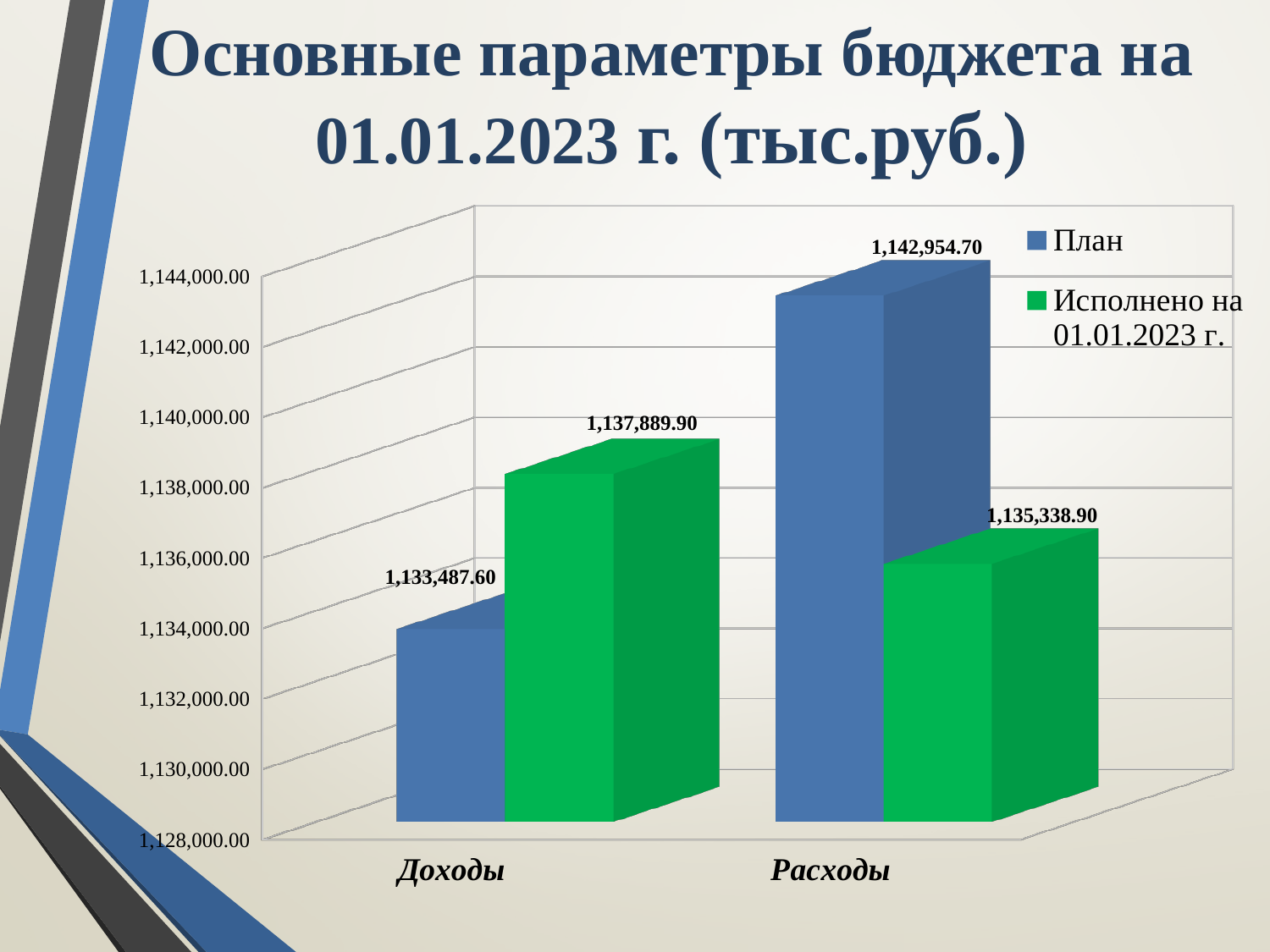
How many categories are shown on the x axis? 2 How many series does the legend list? 2 What is the Исполнено на 01.01.2023 г. value for Доходы? 1,137,889.90 Which bar has the lowest value on the chart? План for Доходы What is the План value for Расходы? 1,142,954.70 What is the План value for Доходы? 1,133,487.60 What is the difference between the План and Исполнено на 01.01.2023 г. values for Расходы? 7,615.80 Which bar has the highest value on the chart? План for Расходы What is the difference between the Исполнено на 01.01.2023 г. and План values for Доходы? 4,402.30 What is the Исполнено на 01.01.2023 г. value for Расходы? 1,135,338.90 For Доходы, which is larger: План or Исполнено на 01.01.2023 г.? Исполнено на 01.01.2023 г. What kind of chart is shown on the slide? Bar chart